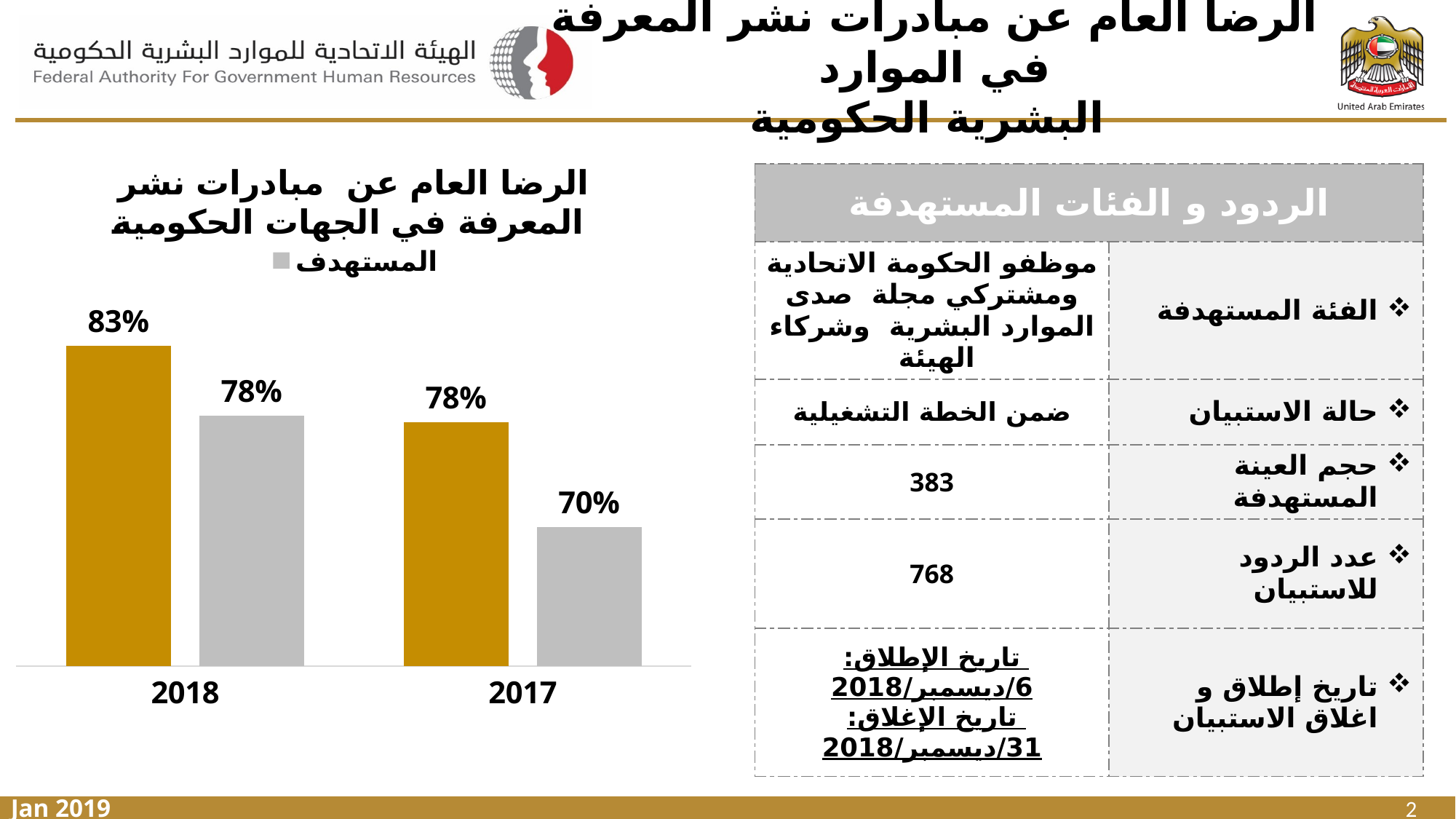
In the bar chart, what is the value of the gold bar for 2017? 78% In the bar chart, what is the value of the gray (المستهدف) bar for 2017? 70% In the bar chart, what is the value of the gold bar for 2018? 83% In the bar chart, what is the value of the gray (المستهدف) bar for 2018? 78% In the bar chart, what is the difference between the gold bar and the gray bar for 2017? 8% In the bar chart, what is the difference between the gold bar and the gray bar for 2018? 5% How many year categories are shown on the x axis of the bar chart? 2 In the bar chart, which year has the lowest gray (المستهدف) bar? 2017 In the bar chart, is the gold bar for 2017 larger or smaller than the gray bar for 2017? larger What type of chart is shown on the left of the slide? bar chart What is the only series name listed in the legend of the bar chart? المستهدف In the bar chart, which year has the highest gold bar? 2018